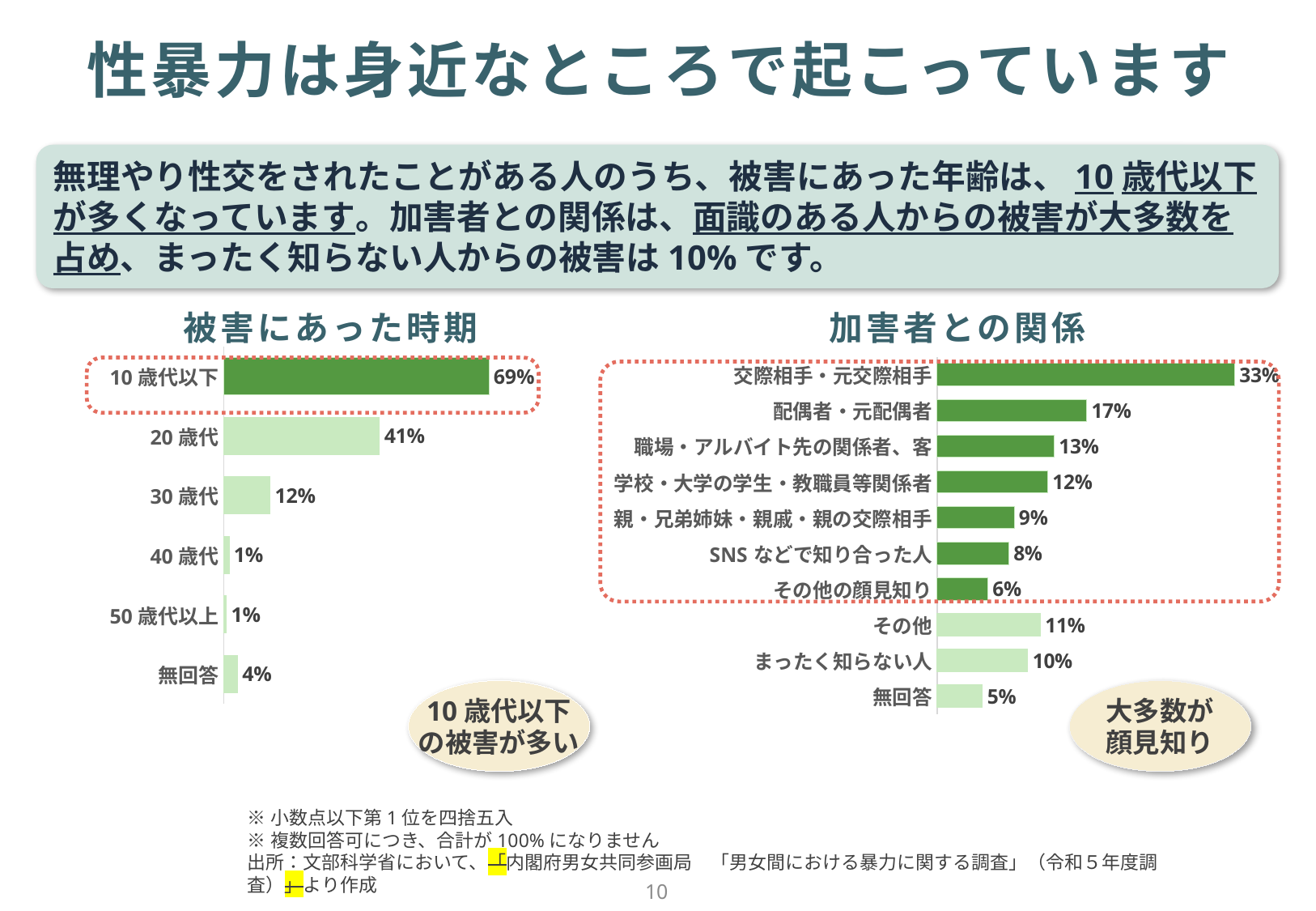
In the 加害者との関係 chart, which is larger: SNSなどで知り合った人 or その他の顔見知り? SNSなどで知り合った人 In the 被害にあった時期 chart, what is the value for 10歳代以下? 69% In the 加害者との関係 chart, what is the value for まったく知らない人? 10% In the 加害者との関係 chart, how many categories are shown? 10 In the 加害者との関係 chart, what is the value for 配偶者・元配偶者? 17% In the 加害者との関係 chart, which category has the lowest value? 無回答 In the 被害にあった時期 chart, how many categories are shown? 6 In the 被害にあった時期 chart, what is the difference between 10歳代以下 and 20歳代? 28% What kind of chart is the 加害者との関係 chart? Bar chart In the 被害にあった時期 chart, what is the value for 30歳代? 12% In the 加害者との関係 chart, which category has the highest value? 交際相手・元交際相手 In the 被害にあった時期 chart, which category has the highest value? 10歳代以下